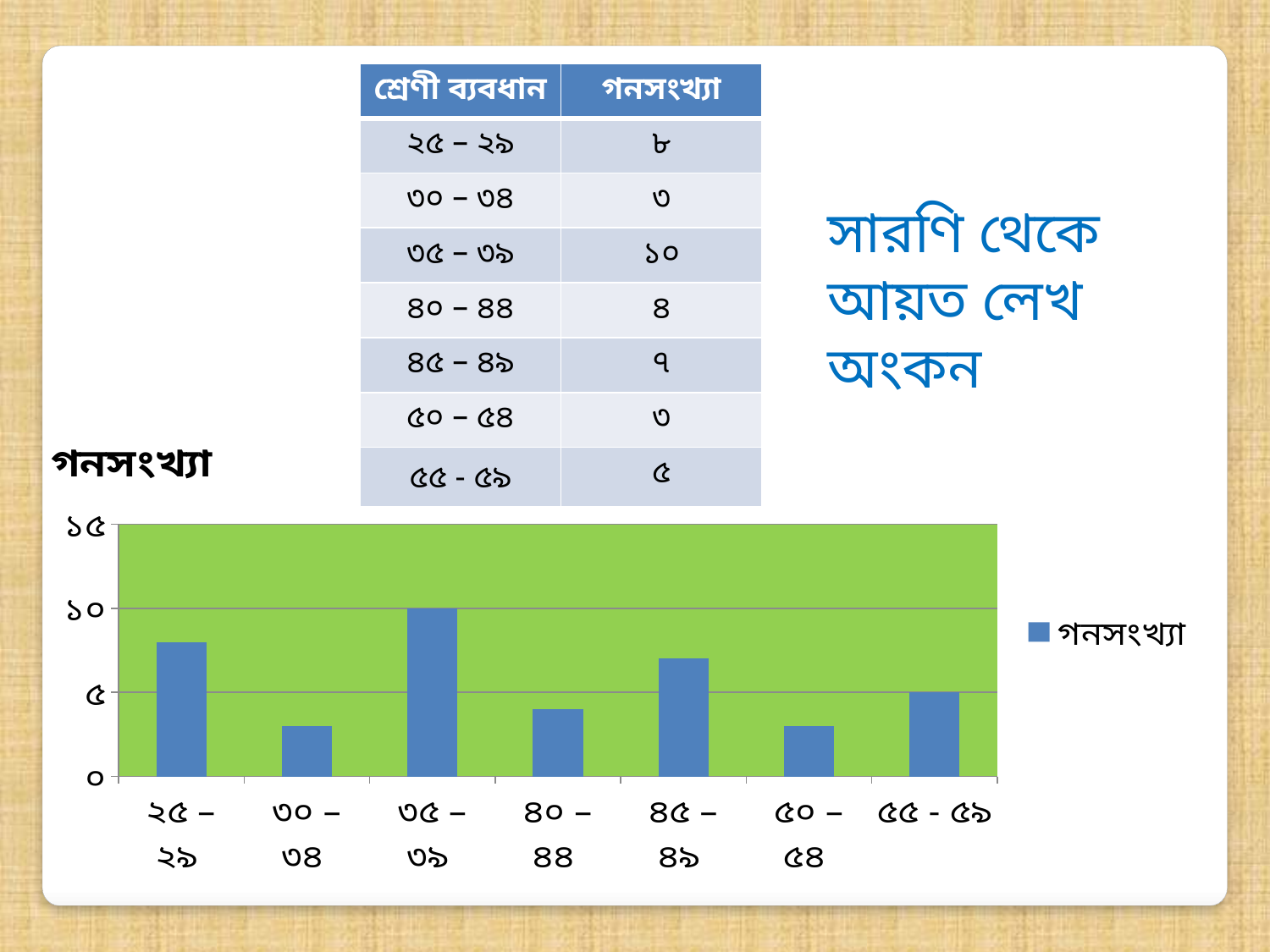
What is the highest tick value shown on the chart's vertical axis? ১৫ What is the value of the bar for ৫৫ - ৫৯? ৫ What kind of chart is shown on the slide? bar chart What is the value of the bar for ৩৫ – ৩৯? ১০ How many series does the chart's legend list? 1 What is the name of the series shown in the chart's legend? গনসংখ্যা How many categories (class intervals) are plotted on the x axis of the chart? 7 Is the value for ২৫ – ২৯ greater or less than ৫? greater Is the value for ৩০ – ৩৪ greater or less than ৫? less Which class interval has the highest bar in the chart? ৩৫ – ৩৯ Which is larger, the bar for ২৫ – ২৯ or the bar for ৪০ – ৪৪? ২৫ – ২৯ What is the difference between the bar for ৩৫ – ৩৯ and the bar for ৫৫ - ৫৯? ৫